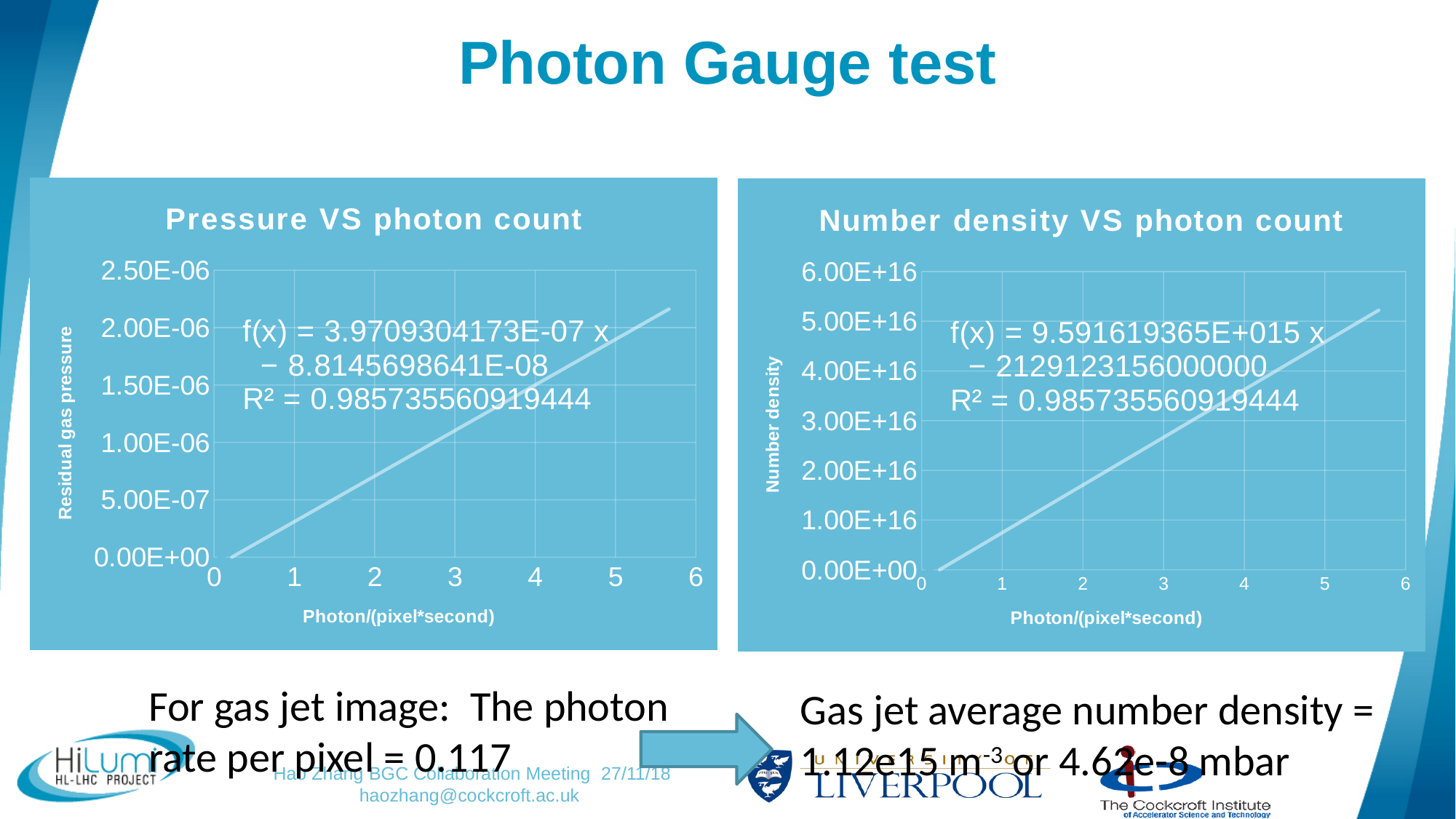
In the 'Pressure VS photon count' chart, what is the R² value printed on the chart? 0.985735560919444 In the 'Number density VS photon count' chart, what is the label of the x axis? Photon/(pixel*second) In the 'Number density VS photon count' chart, do the values rise or fall as the photon count increases along the x axis? rise In the 'Pressure VS photon count' chart, is the residual gas pressure at a photon count of 2 greater or less than 1.00E-06? less In the 'Number density VS photon count' chart, is the number density at a photon count of 2 greater or less than 2.00E+16? less In the 'Pressure VS photon count' chart, what is the label of the y axis? Residual gas pressure In the 'Pressure VS photon count' chart, what is the slope coefficient in the fitted equation f(x)? 3.9709304173E-07 In the 'Number density VS photon count' chart, what is the slope coefficient in the fitted equation f(x)? 9.591619365E+015 In the 'Pressure VS photon count' chart, is the residual gas pressure at a photon count of 5 greater or less than 1.50E-06? greater In the 'Pressure VS photon count' chart, do the values rise or fall along the x axis? rise In the 'Pressure VS photon count' chart, what kind of chart is shown? line chart